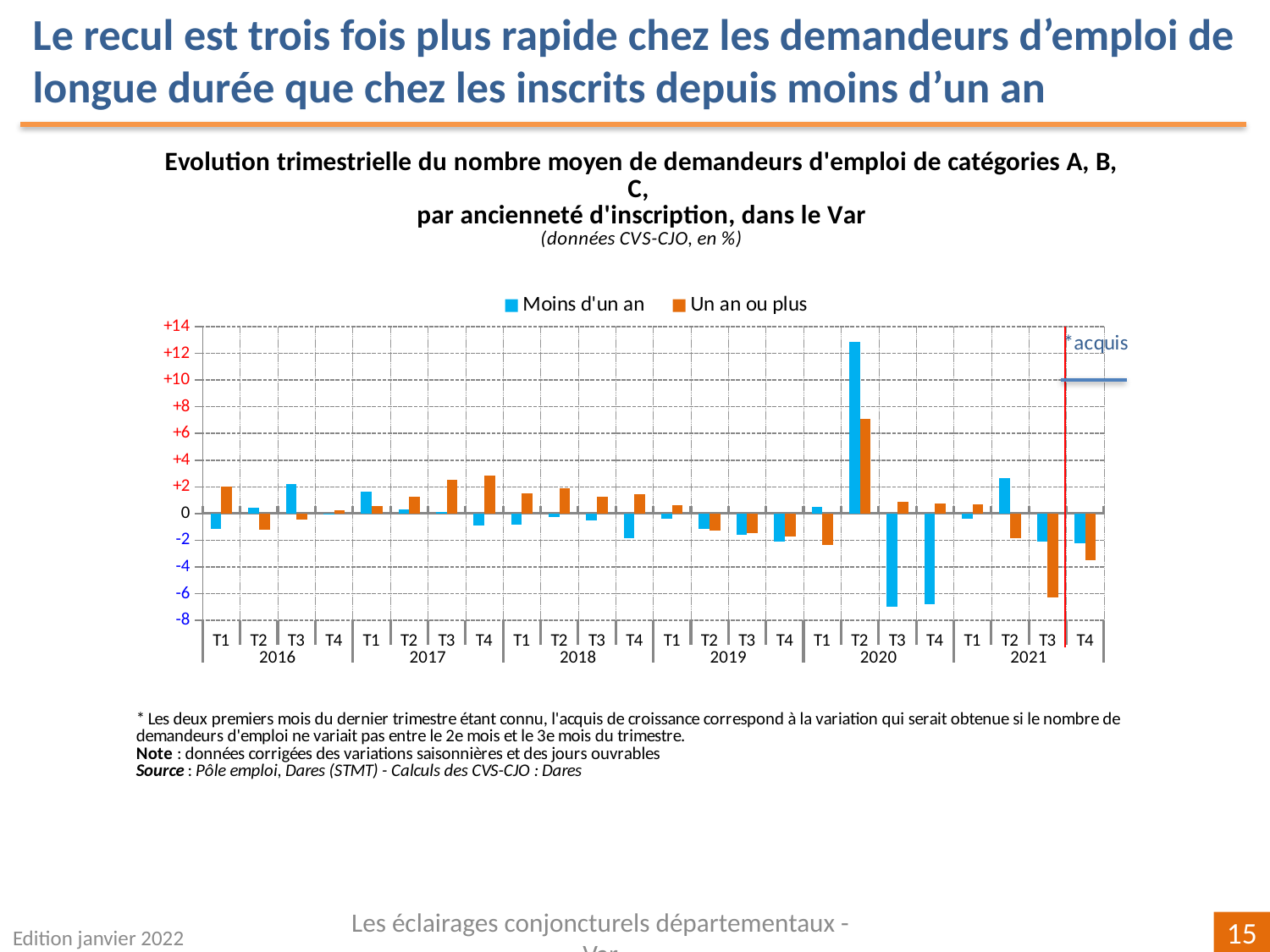
What kind of chart is shown on the slide? bar chart Is the value for 'Moins d'un an' in T3 2020 greater or less than -6? less In which quarter does the 'Un an ou plus' series reach its lowest value? T3 2021 Is the value for 'Moins d'un an' in T2 2020 greater or less than +10? greater In which quarter does the 'Un an ou plus' series reach its highest value? T2 2020 Is the value for 'Un an ou plus' in T3 2021 greater or less than -4? less How many quarters are plotted along the x axis? 24 How many series does the legend list? 2 Which colour represents the 'Un an ou plus' series? orange In T2 2020, which series has the larger value, 'Moins d'un an' or 'Un an ou plus'? Moins d'un an In T4 2017, which series has the larger value, 'Moins d'un an' or 'Un an ou plus'? Un an ou plus In which quarter does the 'Moins d'un an' series reach its highest value? T2 2020